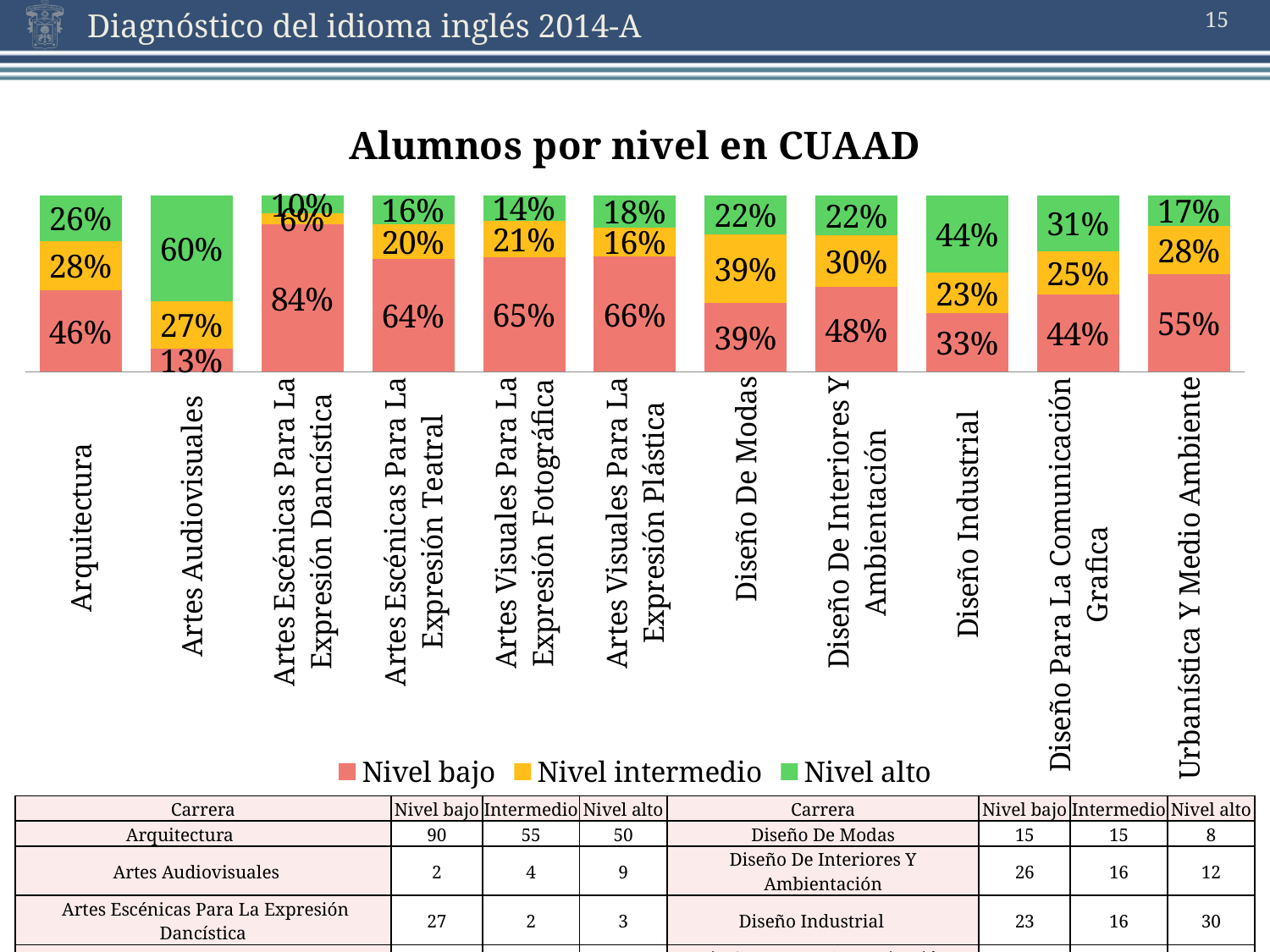
Which carrera has the lowest Nivel bajo percentage? Artes Audiovisuales What is the Nivel alto percentage for Diseño Industrial? 44% Which carrera has the highest Nivel alto percentage? Artes Audiovisuales What type of chart is shown on the slide? Stacked bar chart How many series does the legend list? 3 What is the Nivel bajo percentage for Urbanística Y Medio Ambiente? 55% What is the difference between the Nivel bajo percentages of Artes Visuales Para La Expresión Plástica and Diseño Industrial? 33% What is the Nivel bajo percentage for Arquitectura? 46% Which is larger: the Nivel alto percentage for Diseño Para La Comunicación Grafica or for Diseño De Interiores Y Ambientación? Diseño Para La Comunicación Grafica What is the Nivel intermedio percentage for Diseño De Modas? 39% Which carrera has the highest Nivel bajo percentage? Artes Escénicas Para La Expresión Dancística How many carreras are shown on the x axis of the chart? 11